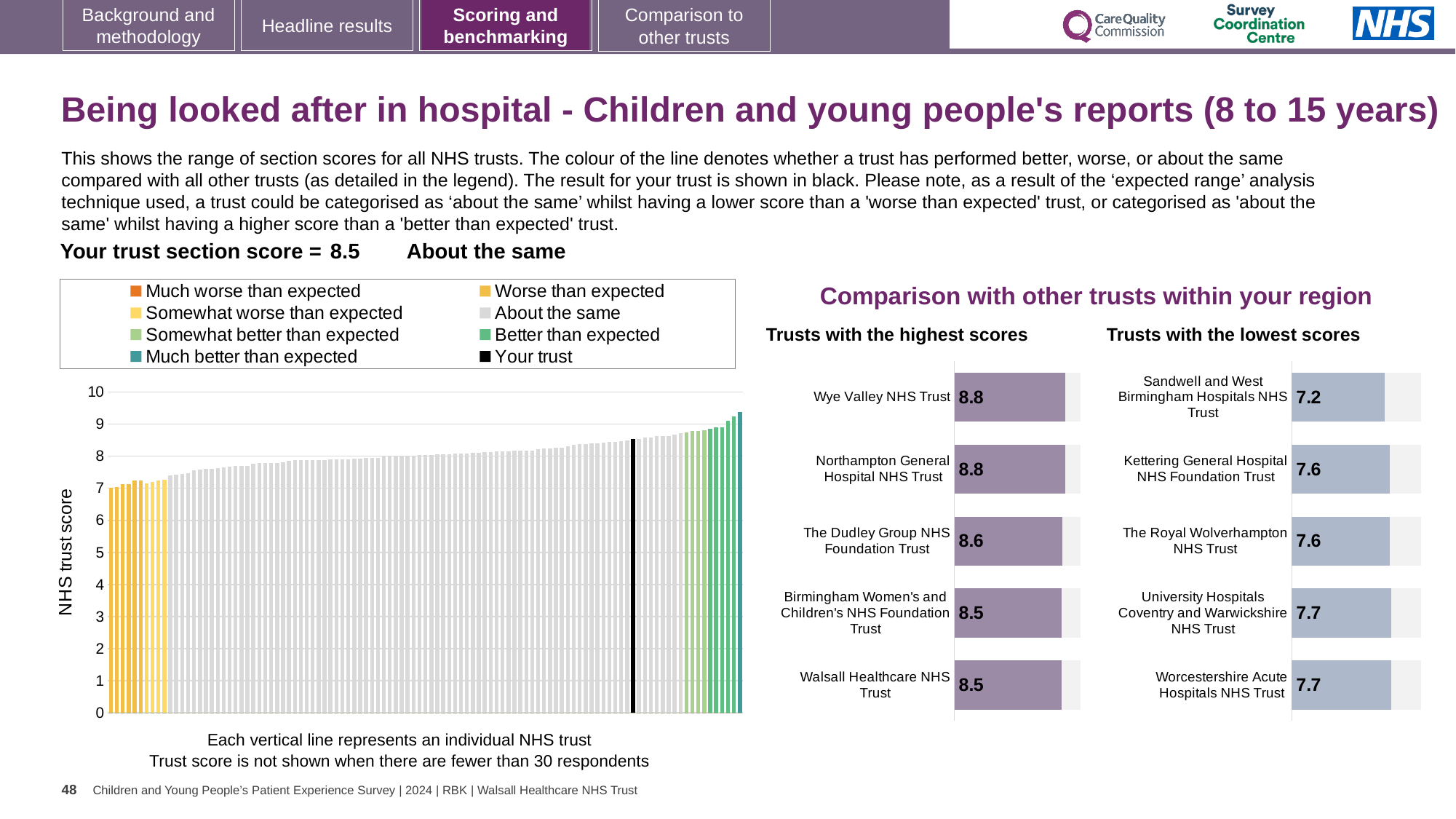
What kind of chart is the large chart on the left of the slide? bar chart In the 'Trusts with the lowest scores' chart, what is the score for Sandwell and West Birmingham Hospitals NHS Trust? 7.2 In the 'Trusts with the highest scores' chart, which has the higher score: The Dudley Group NHS Foundation Trust or Walsall Healthcare NHS Trust? The Dudley Group NHS Foundation Trust In the large chart on the left, is the value for the tallest bar greater or less than 9? greater In the 'Trusts with the highest scores' chart, what is the difference between the scores of Wye Valley NHS Trust and The Dudley Group NHS Foundation Trust? 0.2 In the 'Trusts with the lowest scores' chart, which trust has the lowest score? Sandwell and West Birmingham Hospitals NHS Trust How many trusts are shown in the 'Trusts with the lowest scores' chart? 5 In the 'Trusts with the highest scores' chart, what is the score for Wye Valley NHS Trust? 8.8 In the large chart on the left, is the value for the black bar (Your trust) greater or less than 8? greater In the 'Trusts with the highest scores' chart, what is the score for The Dudley Group NHS Foundation Trust? 8.6 In the 'Trusts with the lowest scores' chart, what is the difference between the scores of Worcestershire Acute Hospitals NHS Trust and Sandwell and West Birmingham Hospitals NHS Trust? 0.5 How many entries does the legend of the large chart on the left list? 8